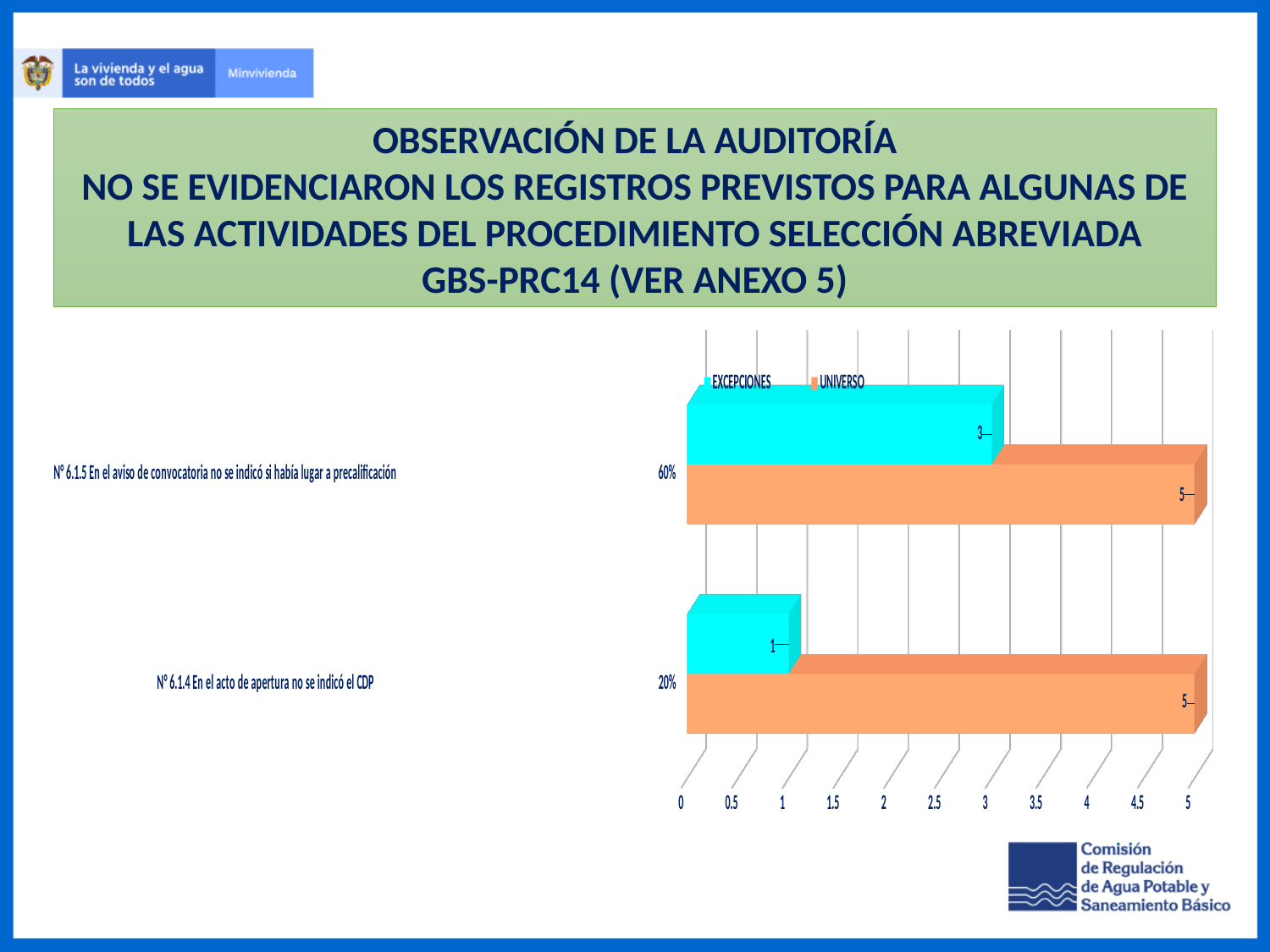
What is the UNIVERSO value for N° 6.1.4 En el acto de apertura no se indicó el CDP? 5 What is the difference between the UNIVERSO and EXCEPCIONES values for N° 6.1.4 En el acto de apertura no se indicó el CDP? 4 What is the EXCEPCIONES value for N° 6.1.5 En el aviso de convocatoria no se indicó si había lugar a precalificación? 3 What is the UNIVERSO value for N° 6.1.5 En el aviso de convocatoria no se indicó si había lugar a precalificación? 5 What kind of chart is shown on the slide? Bar chart What is the EXCEPCIONES value for N° 6.1.4 En el acto de apertura no se indicó el CDP? 1 Which category has the lower EXCEPCIONES value? N° 6.1.4 En el acto de apertura no se indicó el CDP How many series does the legend list? 2 For N° 6.1.5, which is larger: the EXCEPCIONES value or the UNIVERSO value? UNIVERSO What is the difference between the UNIVERSO and EXCEPCIONES values for N° 6.1.5 En el aviso de convocatoria no se indicó si había lugar a precalificación? 2 Which category has the higher EXCEPCIONES value? N° 6.1.5 En el aviso de convocatoria no se indicó si había lugar a precalificación How many categories are shown in the chart? 2